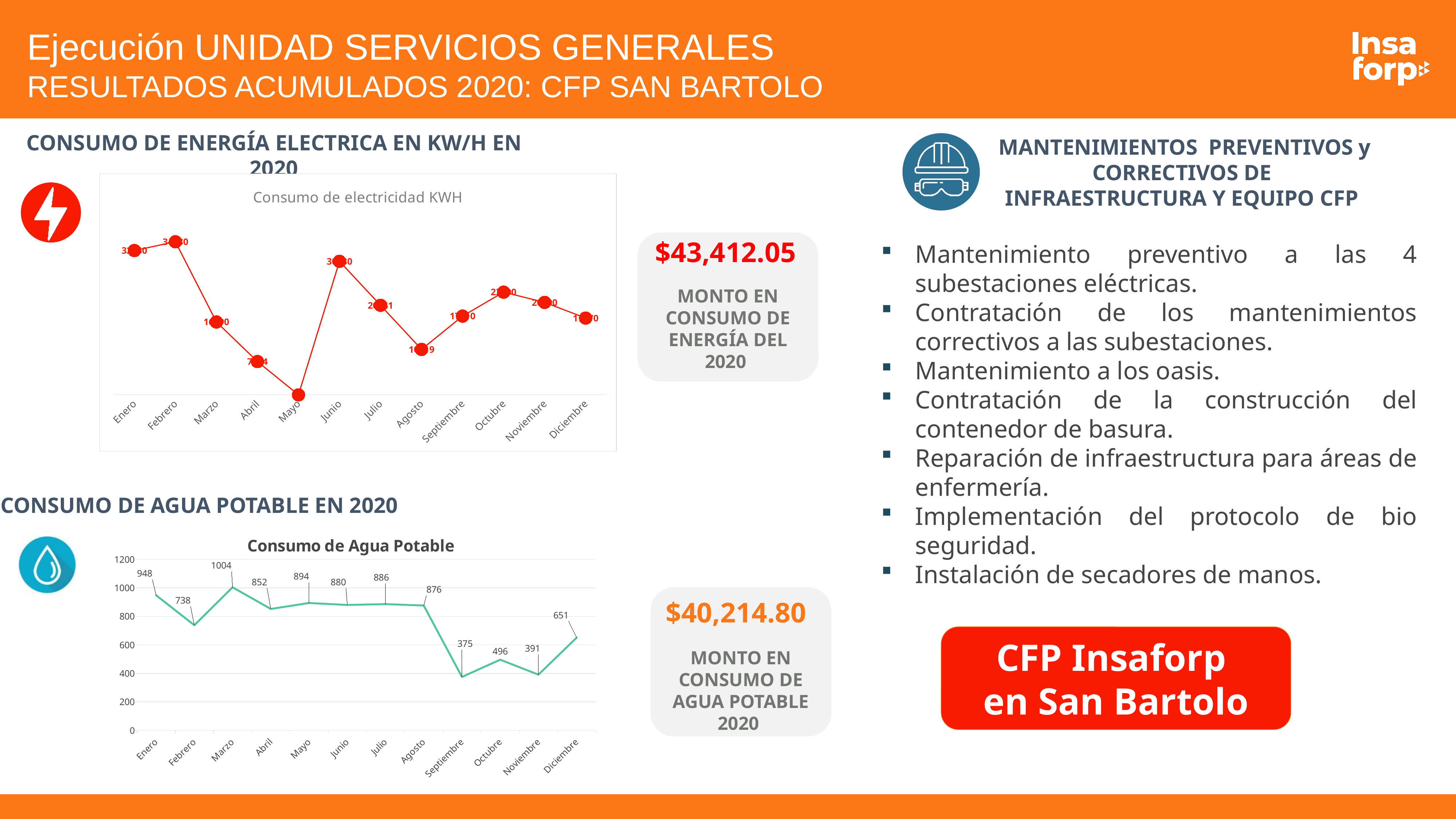
In the 'Consumo de Agua Potable' chart, how many months are plotted? 12 What kind of chart is the 'Consumo de electricidad KWH' chart? Line chart In the 'Consumo de Agua Potable' chart, what is the difference between the values for Enero and Febrero? 210 In the 'Consumo de Agua Potable' chart, what is the value for Septiembre? 375 In the 'Consumo de Agua Potable' chart, what is the value for Marzo? 1004 What kind of chart is the 'Consumo de Agua Potable' chart? Line chart In the 'Consumo de Agua Potable' chart, which month has the highest value? Marzo In the 'Consumo de electricidad KWH' chart, which month has the lowest value? Mayo In the 'Consumo de Agua Potable' chart, what is the value for Diciembre? 651 In the 'Consumo de electricidad KWH' chart, which is larger, the value for Junio or the value for Agosto? Junio In the 'Consumo de Agua Potable' chart, which month has the lowest value? Septiembre In the 'Consumo de Agua Potable' chart, which is larger, the value for Octubre or the value for Noviembre? Octubre